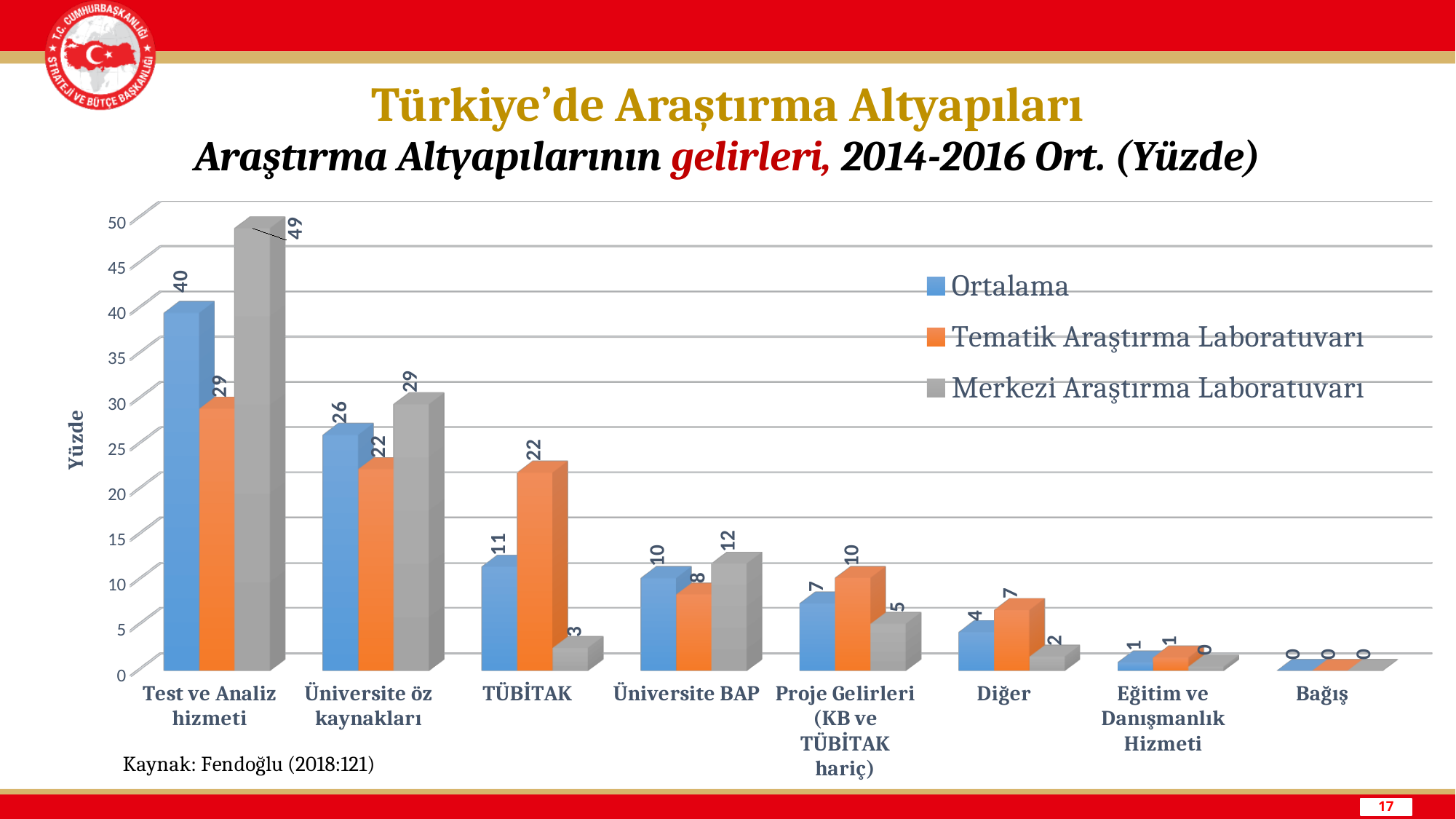
What is the Ortalama value for Test ve Analiz hizmeti? 40 What is the Merkezi Araştırma Laboratuvarı value for Test ve Analiz hizmeti? 49 How many series does the legend list? 3 What is the label of the y axis? Yüzde What is the Merkezi Araştırma Laboratuvarı value for Üniversite BAP? 12 Which category has the highest Ortalama value? Test ve Analiz hizmeti For TÜBİTAK, which is larger: the Tematik Araştırma Laboratuvarı value or the Merkezi Araştırma Laboratuvarı value? Tematik Araştırma Laboratuvarı What kind of chart is shown on the slide? Bar chart Which category has the lowest Tematik Araştırma Laboratuvarı value? Bağış What is the Tematik Araştırma Laboratuvarı value for TÜBİTAK? 22 How many categories are shown on the x axis? 8 What is the difference between the Merkezi Araştırma Laboratuvarı and Tematik Araştırma Laboratuvarı values for Test ve Analiz hizmeti? 20